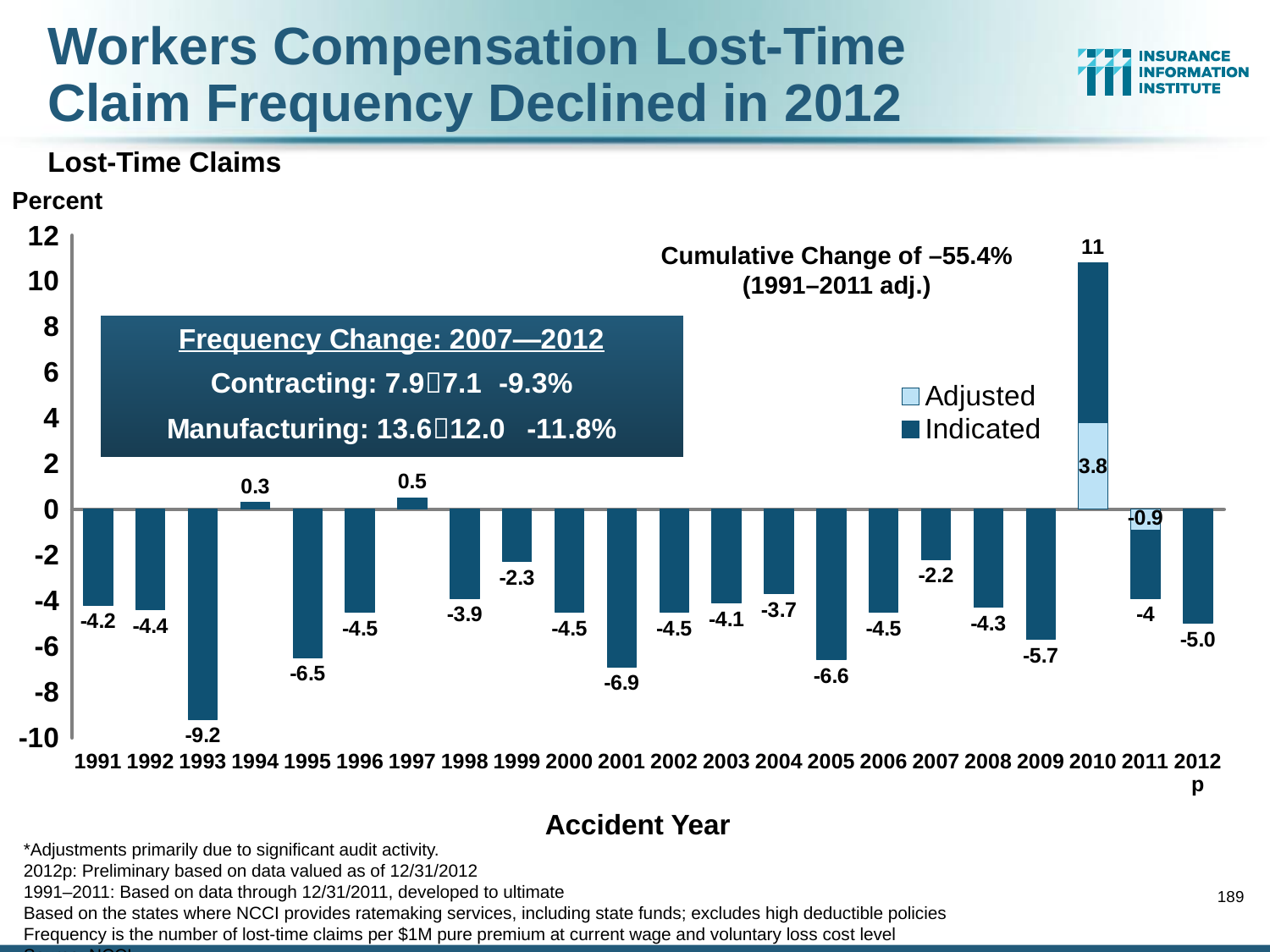
How many accident years are shown on the x axis? 22 What is the value for 2012p? -5.0 What is the label of the x axis? Accident Year What is the Adjusted value shown for 2010? 3.8 Which accident year has the lowest value? 1993 How many series does the legend list? 2 Which is larger, the value for 1997 or the value for 1994? 1997 What is the value for 1993? -9.2 What is the Indicated value shown for 2010? 11 Which accident year has the highest value? 2010 What is the difference between the values for 2001 and 2007? 4.7 What kind of chart is shown? Bar chart